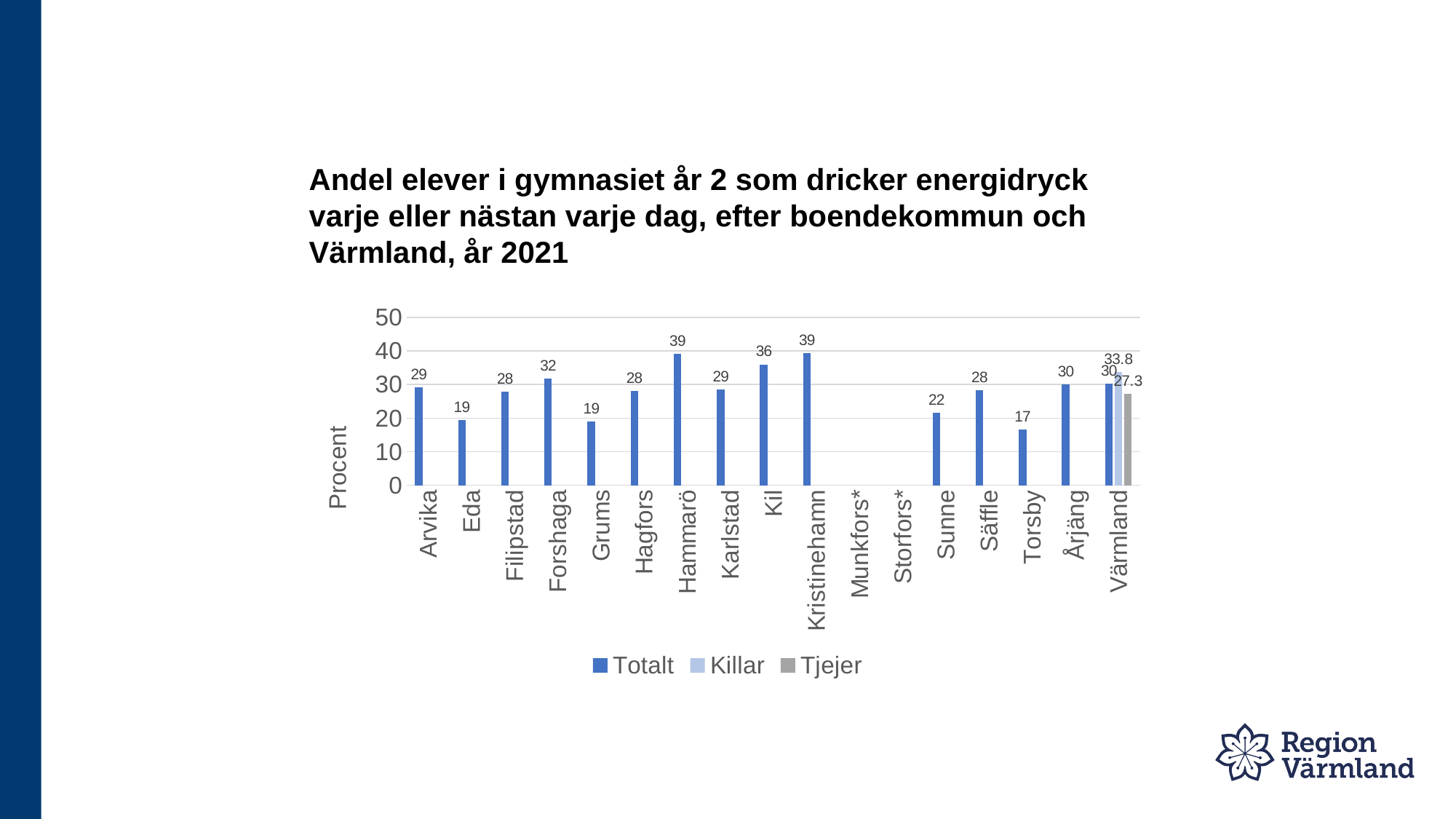
What is the Killar value for Värmland? 33.8 What is the difference between the Killar and Tjejer values for Värmland? 6.5 How many series does the legend list? 3 What is the Totalt value for Torsby? 17 What is the Tjejer value for Värmland? 27.3 Which has a higher Totalt value, Forshaga or Karlstad? Forshaga Which municipality has the lowest Totalt value? Torsby What kind of chart is shown on the slide? Bar chart What is the label on the y axis? Procent What is the difference between the Totalt values for Kil and Eda? 17 How many categories are shown on the x axis? 17 What is the Totalt value for Hammarö? 39